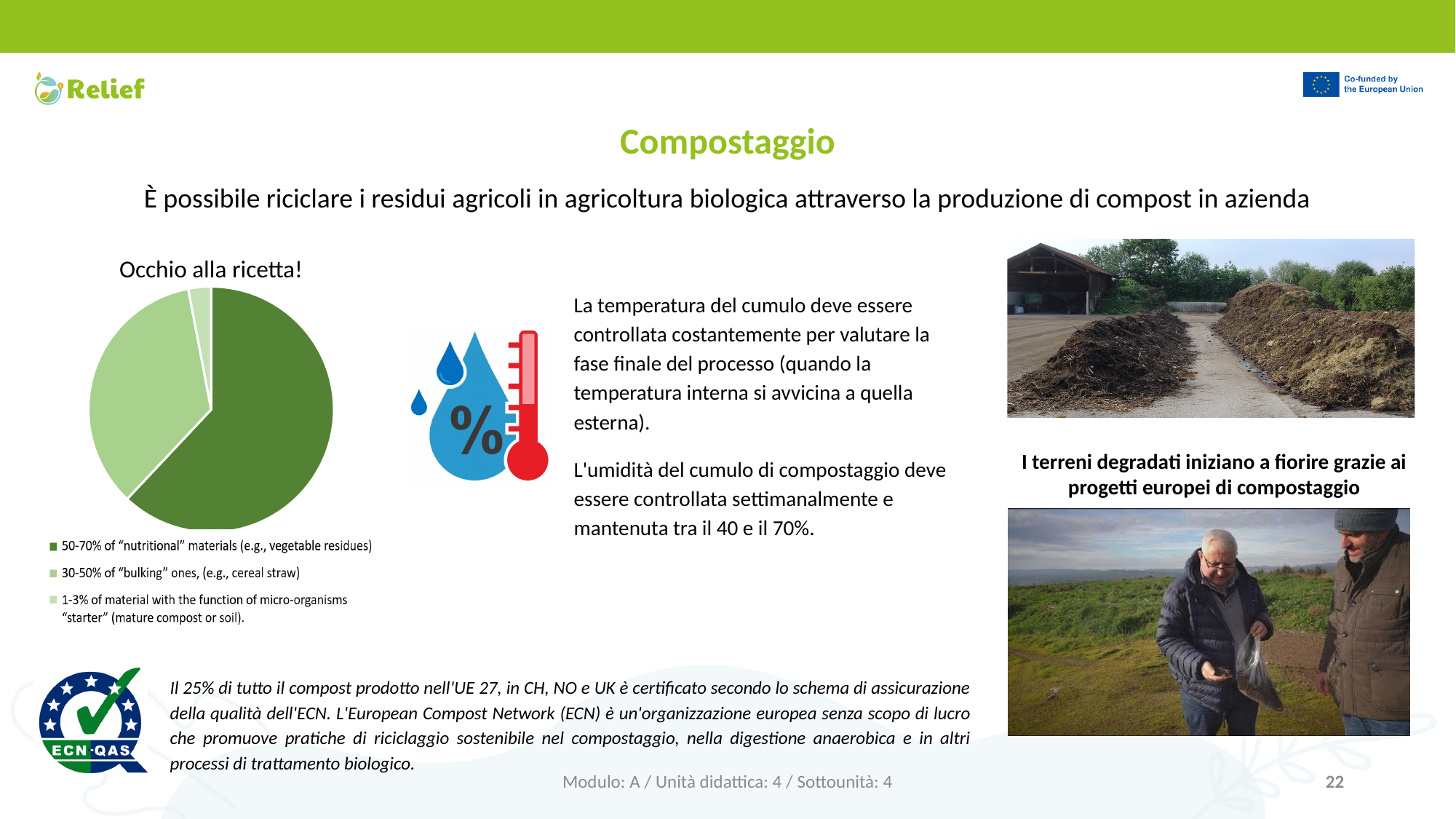
Which slice is larger in the pie chart: "bulking" ones or the micro-organisms "starter" material? "bulking" ones How many entries does the legend of the pie chart list? 3 What colour is the slice for "bulking" materials in the pie chart? Light green How many slices does the pie chart have? 3 What is the title shown above the pie chart? Occhio alla ricetta! Which category takes up the largest slice of the pie chart? 50-70% of "nutritional" materials (e.g., vegetable residues) What kind of chart is shown on the slide? Pie chart Which slice is larger in the pie chart: "nutritional" materials or "bulking" ones? "nutritional" materials Which category takes up the smallest slice of the pie chart? 1-3% of material with the function of micro-organisms "starter" (mature compost or soil)